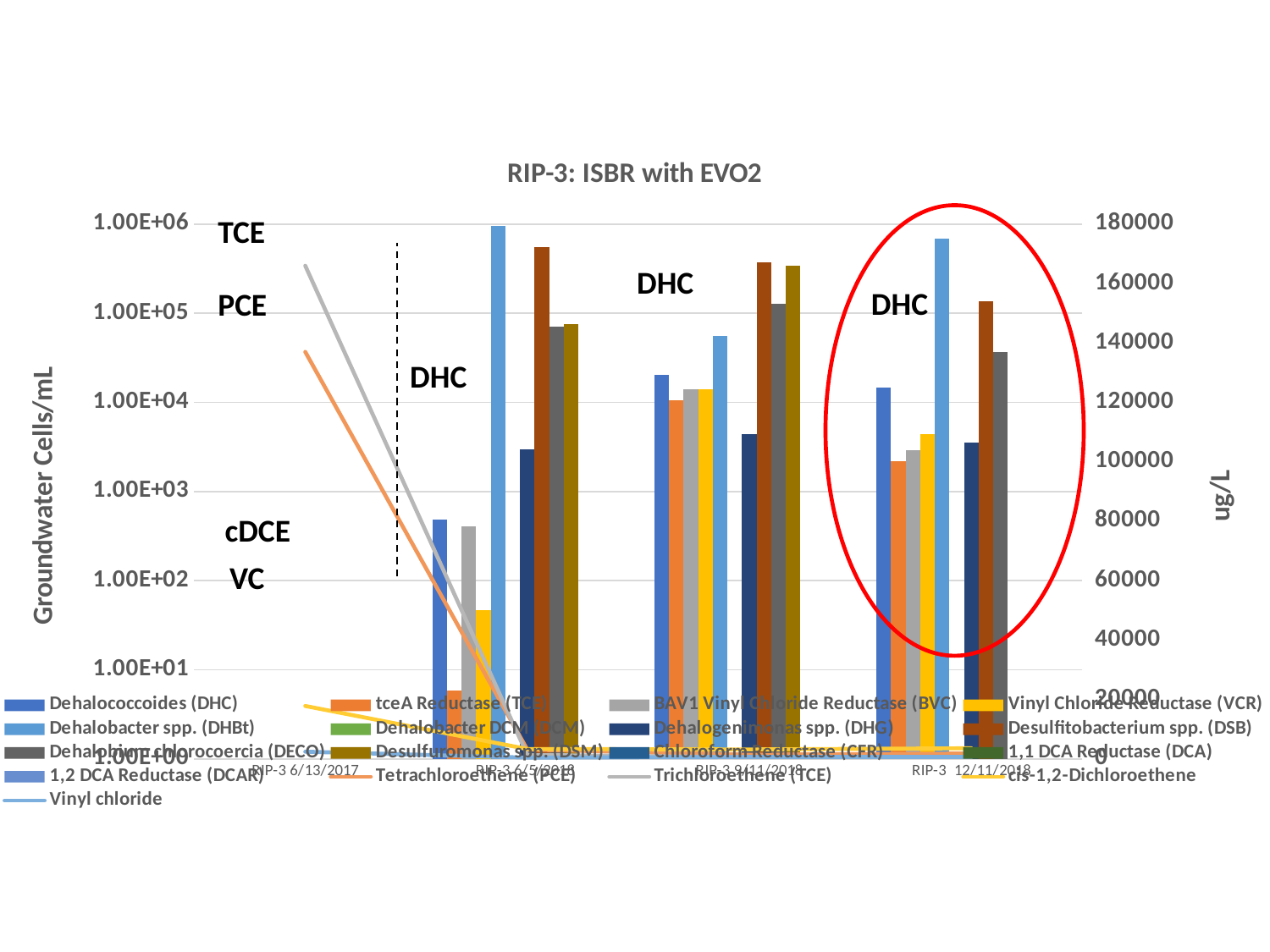
What is the title of the left vertical axis? Groundwater Cells/mL Is the value for Vinyl Chloride Reductase (VCR) at RIP-3 6/5/2018 greater or less than 1.00E+02? less How many series does the legend list? 17 Is the value for Dehalobacter spp. (DHBt) at RIP-3 9/11/2018 greater or less than 1.00E+04? greater Is the Desulfitobacterium spp. (DSB) value higher at RIP-3 9/11/2018 or at RIP-3 12/11/2018? RIP-3 9/11/2018 Is the value for tceA Reductase (TCE) at RIP-3 6/5/2018 greater or less than 1.00E+01? less What kind of chart is shown on the slide? Combination bar and line chart How many sampling dates (categories) are shown on the x axis? 4 Which series has the highest bar at RIP-3 12/11/2018? Dehalobacter spp. (DHBt) At which sampling date is the Dehalobacter spp. (DHBt) bar the tallest? RIP-3 6/5/2018 What is the title of the chart? RIP-3: ISBR with EVO2